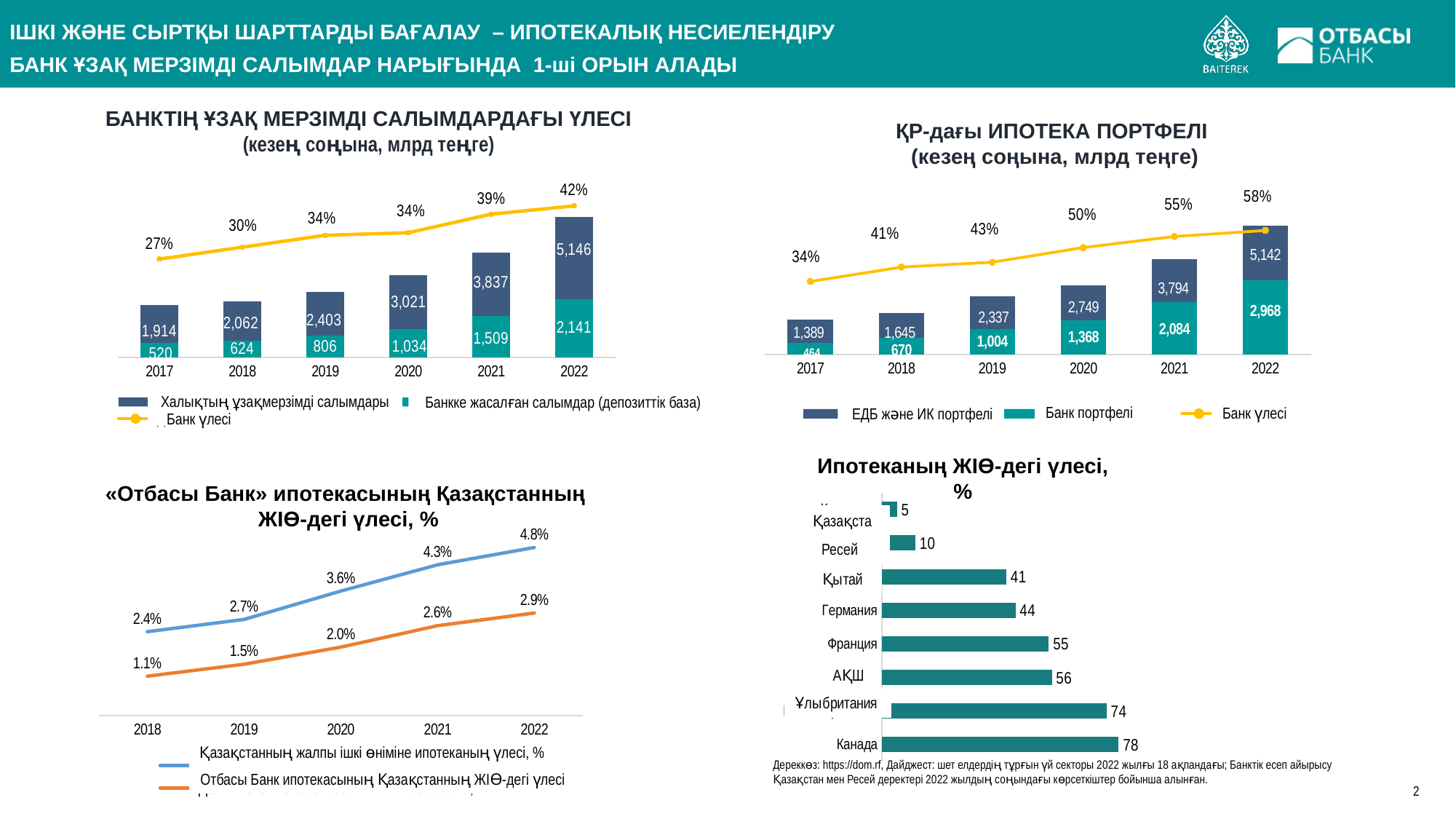
In the chart 'Ипотеканың ЖІӨ-дегі үлесі, %', which country has the highest value? Канада In the chart 'БАНКТІҢ ҰЗАҚ МЕРЗІМДІ САЛЫМДАРДАҒЫ ҮЛЕСІ', does the 'Банк үлесі' line rise or fall from 2017 to 2022? rise What type of chart is 'Ипотеканың ЖІӨ-дегі үлесі, %'? bar chart In the chart 'ҚР-дағы ИПОТЕКА ПОРТФЕЛІ', what is the value of 'Банк портфелі' for 2022? 2,968 In the chart 'Ипотеканың ЖІӨ-дегі үлесі, %', how many countries are shown? 8 In the chart 'БАНКТІҢ ҰЗАҚ МЕРЗІМДІ САЛЫМДАРДАҒЫ ҮЛЕСІ', what is the difference between the 'Банкке жасалған салымдар' values for 2022 and 2021? 632 In the chart '«Отбасы Банк» ипотекасының Қазақстанның ЖІӨ-дегі үлесі, %', what is the difference between the two lines' values in 2022? 1.9% In the chart 'БАНКТІҢ ҰЗАҚ МЕРЗІМДІ САЛЫМДАРДАҒЫ ҮЛЕСІ', what is the value of 'Халықтың ұзақмерзімді салымдары' for 2021? 3,837 In the chart '«Отбасы Банк» ипотекасының Қазақстанның ЖІӨ-дегі үлесі, %', what is the value of the 'Отбасы Банк ипотекасының Қазақстанның ЖІӨ-дегі үлесі' line for 2020? 2.0% In the chart 'Ипотеканың ЖІӨ-дегі үлесі, %', what is the value for Германия? 44 In the chart 'ҚР-дағы ИПОТЕКА ПОРТФЕЛІ', what is the 'Банк үлесі' percentage for 2020? 50% In the chart 'Ипотеканың ЖІӨ-дегі үлесі, %', which country has the lowest value? Қазақстан